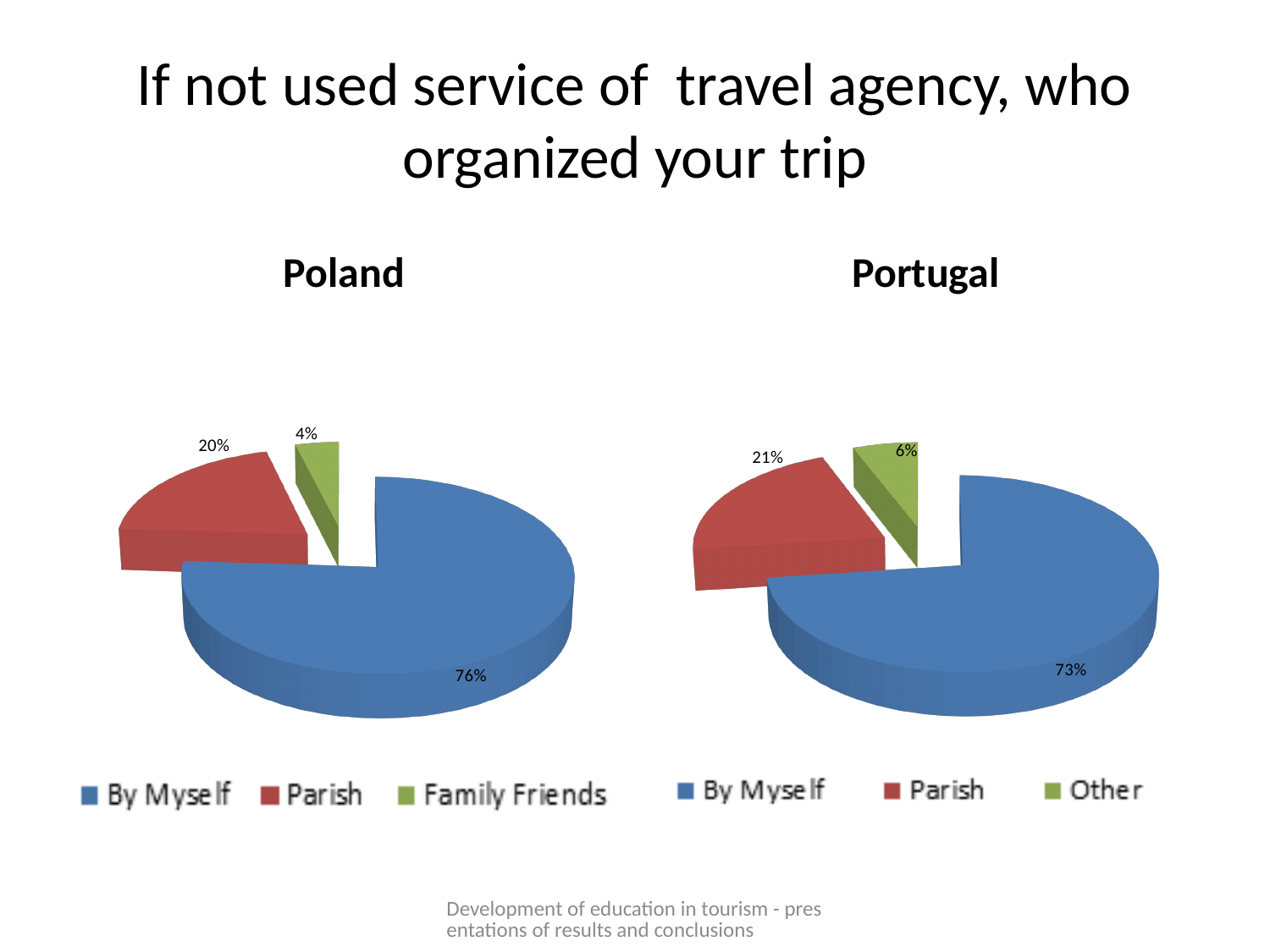
In the Poland chart, what percentage is shown for Parish? 20% In the Portugal chart, what share of respondents organized the trip by themselves? 73% Which is larger: the By Myself share in Poland or the By Myself share in Portugal? Poland In the Portugal chart, what percentage is shown for Other? 6% What is the difference between the Parish share in Portugal and the Parish share in Poland? 1% In the Poland chart, which category has the smallest share? Family Friends In the Portugal chart, which category has the largest share? By Myself What type of chart is used for Poland? Pie chart How many categories does the Portugal chart show? 3 What is the third legend entry in the Portugal chart? Other In the Poland chart, what is the difference between the By Myself share and the Parish share? 56% In the Poland chart, what share of respondents organized the trip by themselves? 76%